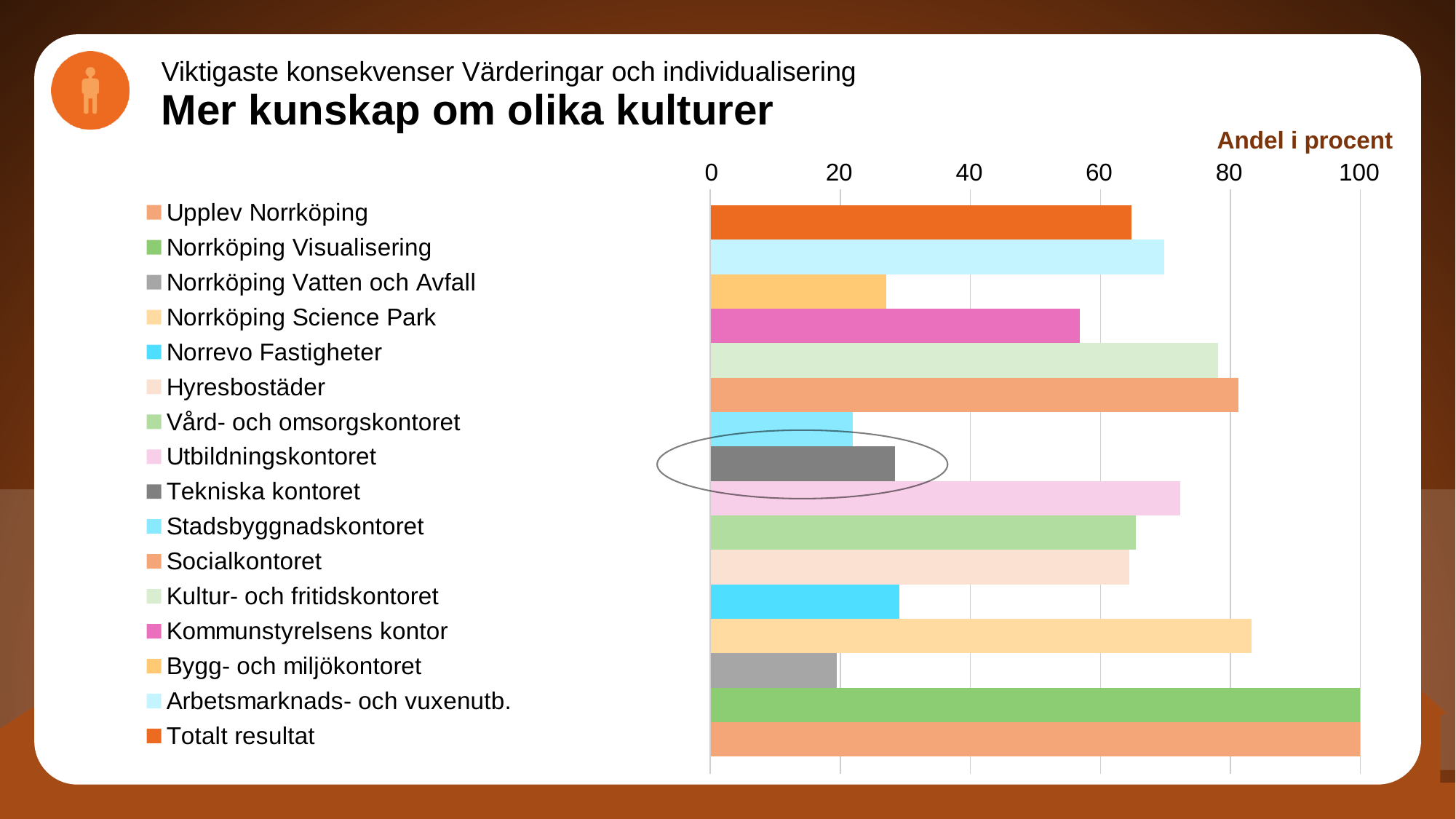
Which is larger, the value for Arbetsmarknads- och vuxenutb. or the value for Norrevo Fastigheter? Arbetsmarknads- och vuxenutb. How many bars are plotted in the chart? 16 Which series' bar is circled on the chart? Tekniska kontoret What label is shown above the horizontal axis of the chart? Andel i procent Is the value for Kultur- och fritidskontoret greater or less than 60? greater How many series does the legend list? 16 Is the value for Totalt resultat greater or less than 60? greater Is the value for Norrköping Vatten och Avfall greater or less than 40? less What kind of chart is shown on the slide? bar chart Which is larger, the value for Socialkontoret or the value for Stadsbyggnadskontoret? Socialkontoret